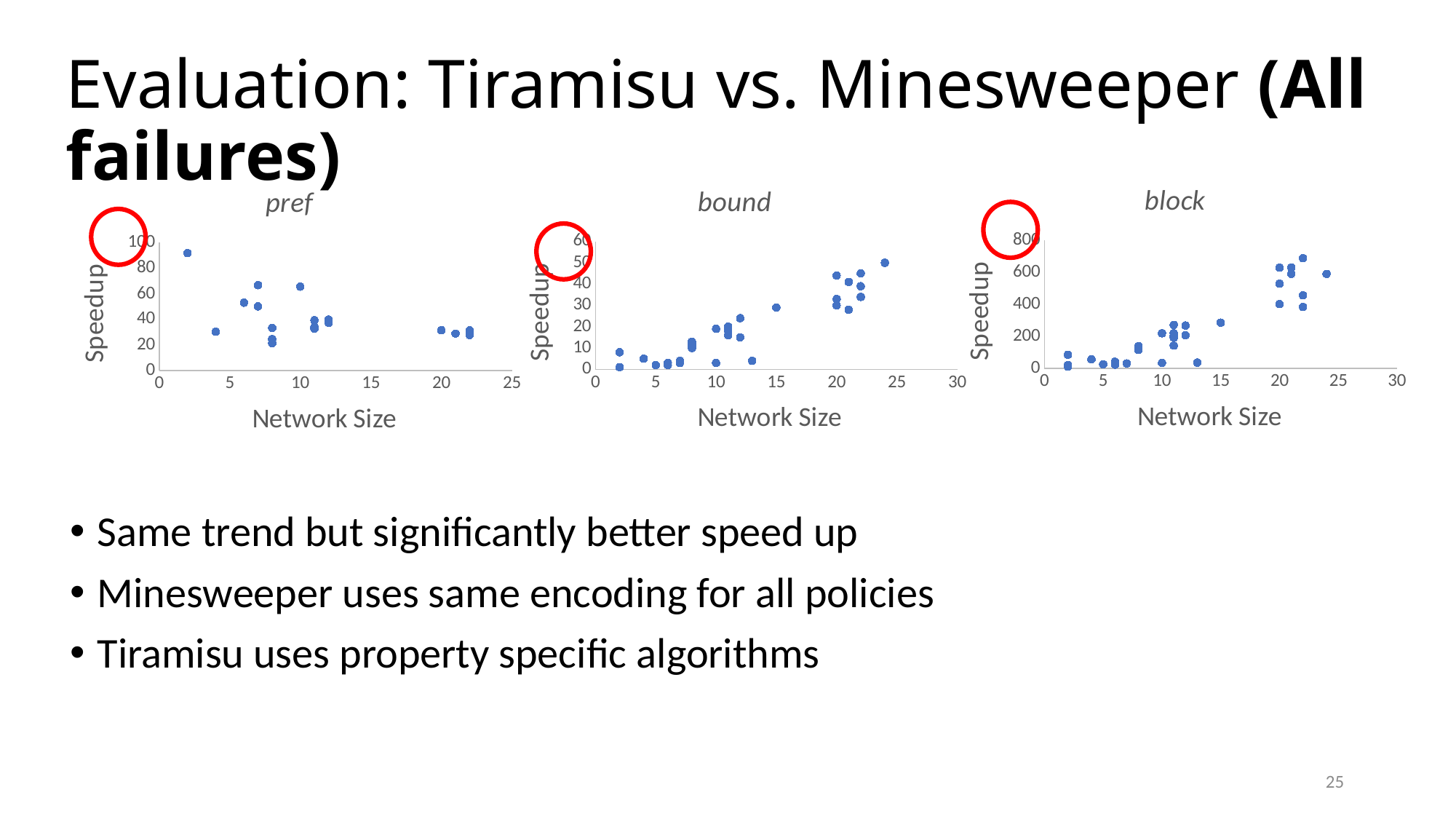
In the chart titled "bound", is the speedup for the point at network size 15 greater or less than 20? greater In the chart titled "bound", do the speedup values generally rise or fall as network size increases? rise In the chart titled "pref", is the speedup for the point at network size 4 greater or less than 40? less In the chart titled "block", is the speedup for the point at network size 15 greater or less than 400? less What kind of chart is the chart titled "pref"? scatter chart What is the title of the middle chart? bound In the chart titled "block", do the speedup values generally rise or fall as network size increases? rise What is the label of the x axis on the chart titled "block"? Network Size How many charts are shown on the slide? 3